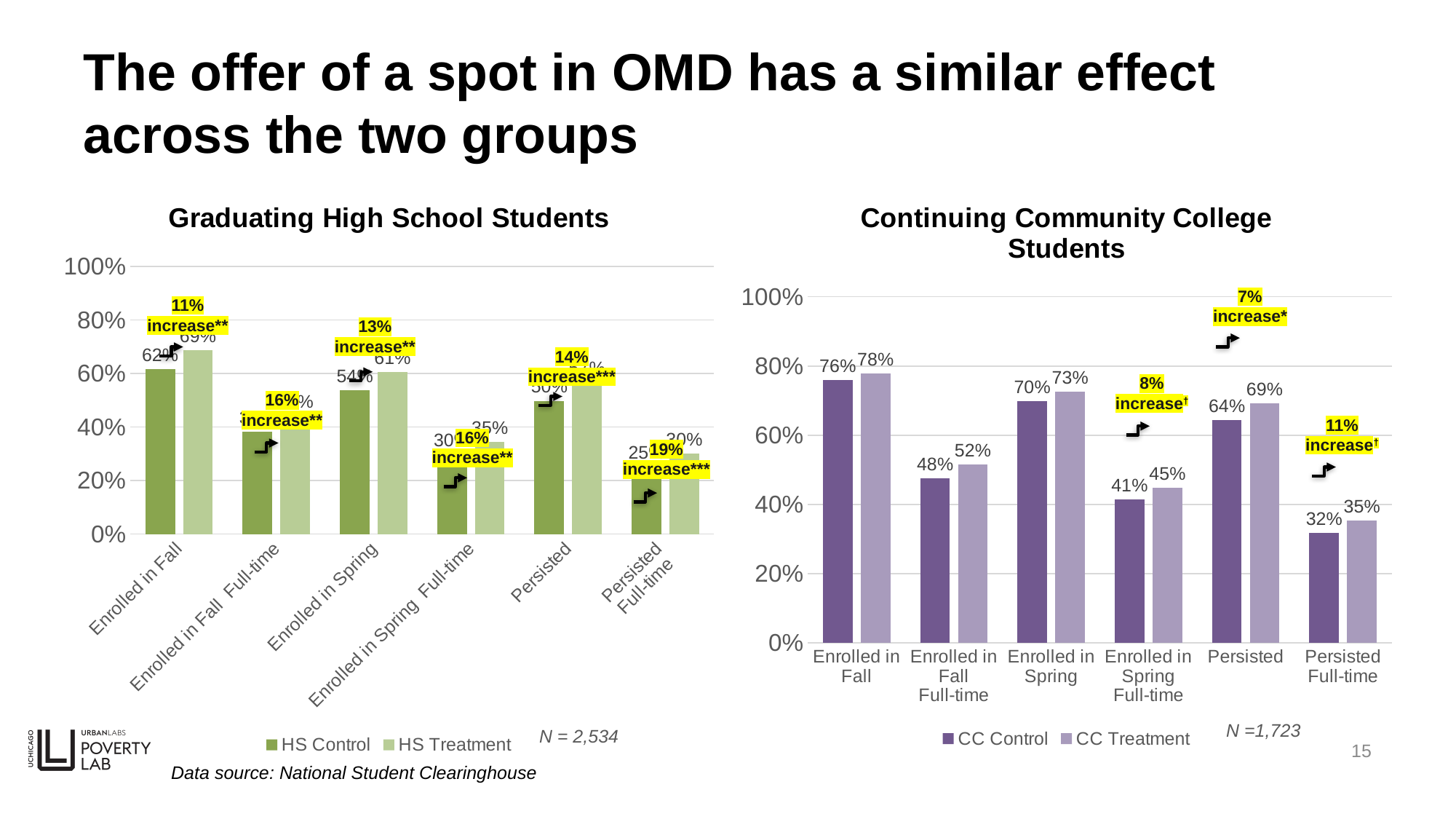
In the Continuing Community College Students chart, what is the difference between CC Treatment and CC Control for Enrolled in Fall Full-time? 4 percentage points In the Continuing Community College Students chart, what is the value for CC Treatment for Persisted? 69% How many categories are shown on the x axis of the Continuing Community College Students chart? 6 What sample size (N) is shown for the Continuing Community College Students chart? N =1,723 What kind of chart is the Graduating High School Students chart? Bar chart In the Graduating High School Students chart, what is the value for HS Control for Enrolled in Spring? 54% In the Graduating High School Students chart, what is the value for HS Treatment for Enrolled in Fall? 69% In the Continuing Community College Students chart, which category has the highest CC Treatment value? Enrolled in Fall In the Continuing Community College Students chart, which category has the lowest CC Control value? Persisted Full-time How many series does the legend of the Continuing Community College Students chart list? 2 In the Continuing Community College Students chart, which is larger for CC Control: Enrolled in Spring or Persisted? Enrolled in Spring In the Continuing Community College Students chart, what is the value for CC Control for Enrolled in Fall? 76%